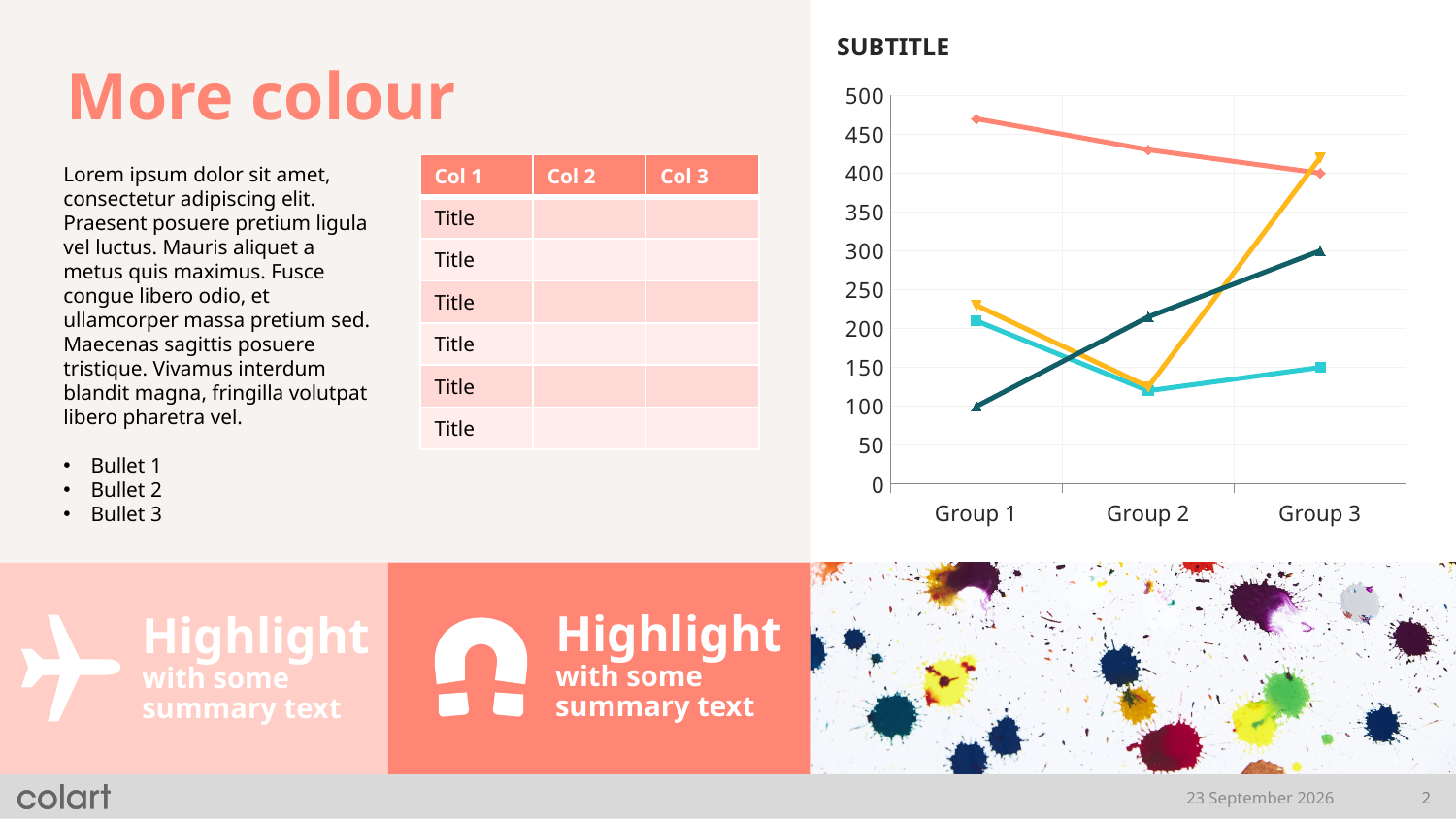
Does the dark teal line rise or fall from Group 1 to Group 3? rise How many categories are shown on the x axis of the chart? 3 What kind of chart is shown on the slide? line chart Is the value of the orange line at Group 2 greater or less than 150? less Is the value of the dark teal line at Group 1 greater or less than 150? less Does the salmon/pink line rise or fall from Group 1 to Group 3? fall Is the value of the orange line at Group 3 greater or less than 400? greater What is the title shown above the chart? SUBTITLE What are the category labels on the x axis of the chart? Group 1, Group 2, Group 3 For the salmon/pink line, which group has the highest value? Group 1 At Group 3, which line has the larger value: the orange line or the light cyan line? the orange line